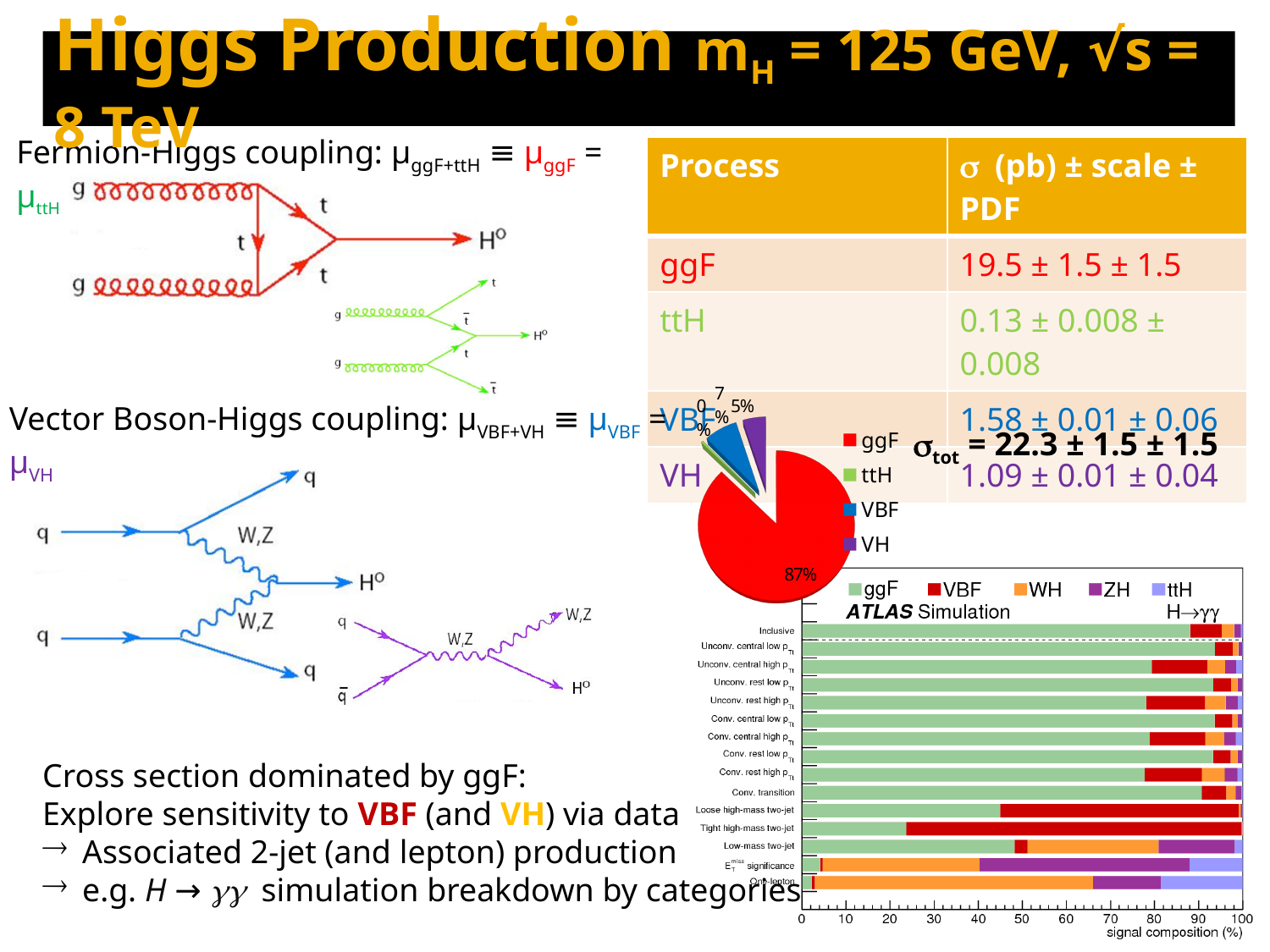
On the ATLAS Simulation H→γγ bar chart, is the ggF signal composition for the Inclusive category greater or less than 80%? greater On the pie chart, what share does VBF account for? 7% On the ATLAS Simulation H→γγ bar chart, in the Tight high-mass two-jet category, which is larger: the ggF or the VBF contribution? VBF How many series does the legend of the ATLAS Simulation H→γγ bar chart list? 5 On the pie chart, which process has the largest slice? ggF On the pie chart, how many percentage points larger is the ggF share than the VBF share? 80 On the pie chart, what share does VH account for? 5% How many categories are shown on the ATLAS Simulation H→γγ bar chart? 15 What kind of chart is the ATLAS Simulation H→γγ chart at the bottom right? Stacked bar chart How many entries does the pie chart's legend list? 4 On the pie chart, what share of the total does ggF account for? 87% On the ATLAS Simulation H→γγ bar chart, is the ggF signal composition for the Tight high-mass two-jet category greater or less than 30%? less